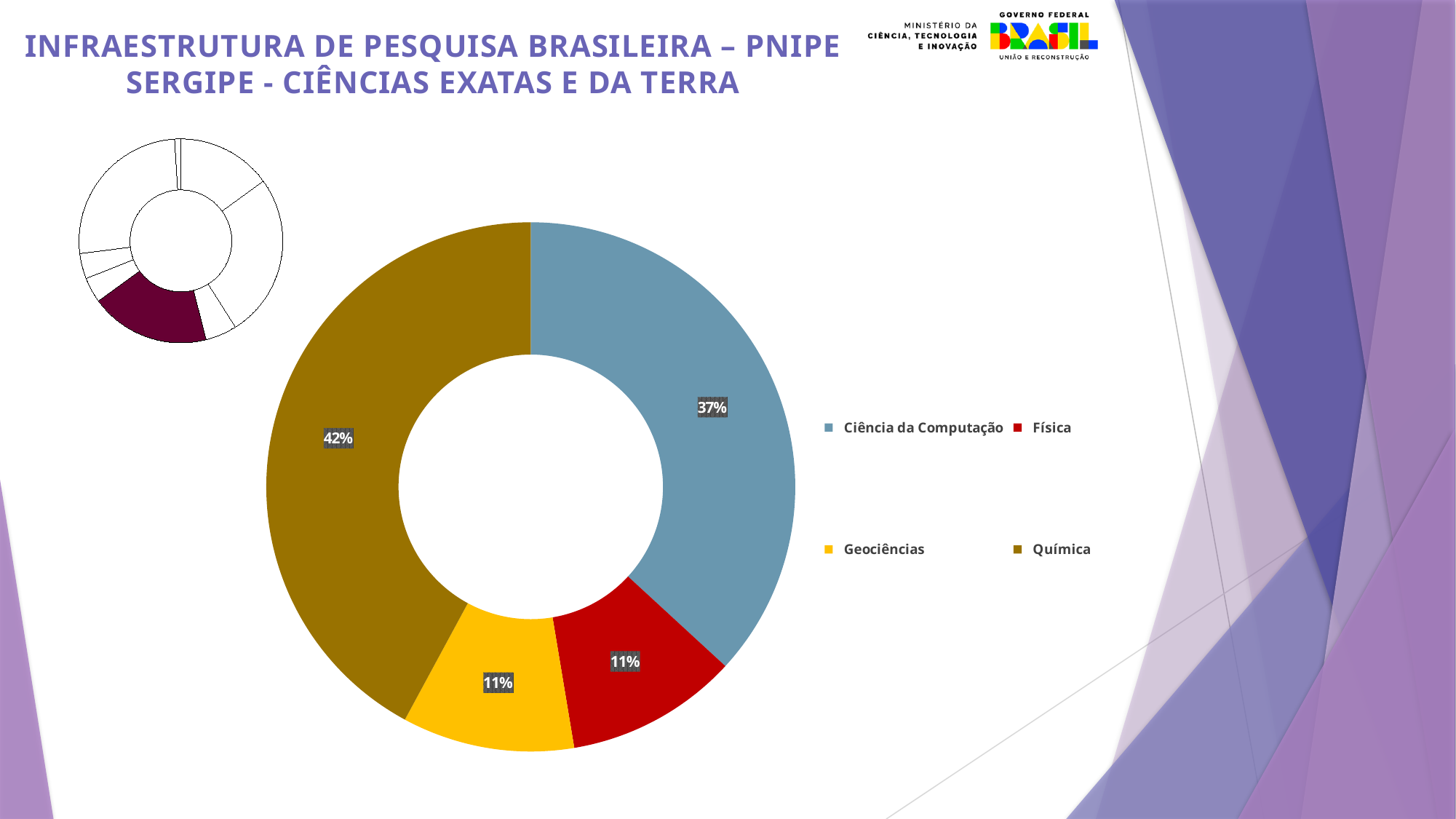
In the large doughnut chart, which is larger: the share for Química or the share for Ciência da Computação? Química In the large doughnut chart, what is the difference in percentage points between Química and Ciência da Computação? 5 percentage points How many categories are shown in the large doughnut chart? 4 In the large doughnut chart, what share does Física have? 11% In the large doughnut chart, what share does Geociências have? 11% In the large doughnut chart, what share does Ciência da Computação have? 37% In the large doughnut chart, which category has the largest share? Química What type of chart is the large chart in the centre of the slide? Doughnut (pie) chart In the large doughnut chart, what share does Química have? 42% In the large doughnut chart, what is the difference in percentage points between Ciência da Computação and Física? 26 percentage points How many entries does the legend of the large doughnut chart list? 4 In the large doughnut chart, what colour represents Física? Red